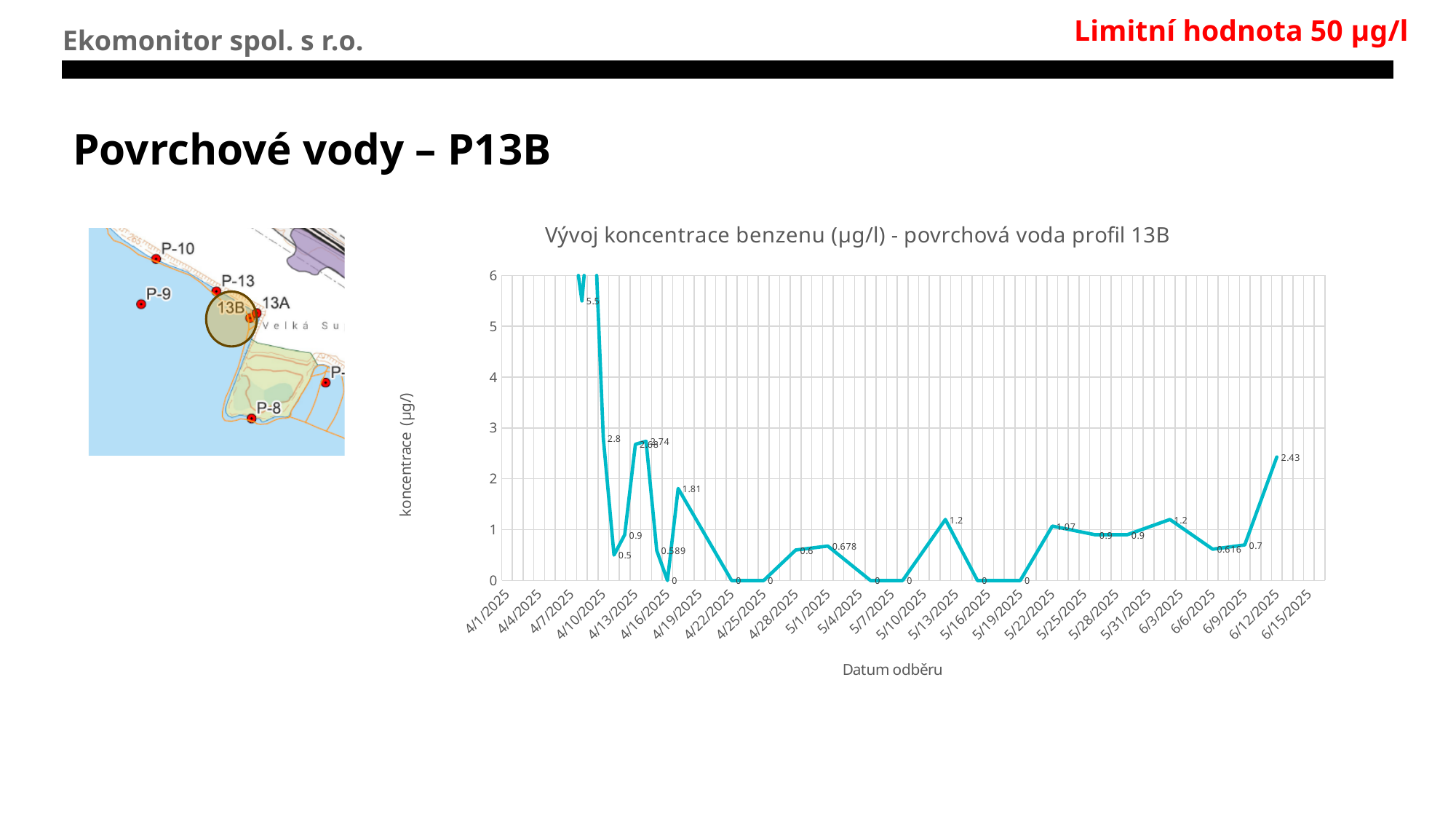
How many data series are plotted on the chart? 1 What kind of chart is shown on the slide? line chart Do the plotted values generally rise or fall between 4/10/2025 and 4/22/2025? fall What is the lowest value plotted on the chart? 0 What is the difference between the last plotted value (2.43) and the peak value around 4/19/2025 (1.81)? 0.62 Is the value of the last plotted point (around 6/12/2025) greater or less than 2? greater What is the title of the chart? Vývoj koncentrace benzenu (µg/l) - povrchová voda profil 13B What is the label of the vertical axis of the chart? koncentrace (µg/l) Which is larger: the peak value around 4/19/2025 or the value of the last plotted point around 6/12/2025? the last plotted point (2.43) What is the value of the last plotted point on the chart (around 6/12/2025)? 2.43 Is the peak value around 4/19/2025 greater or less than 2? less Do the plotted values rise or fall between 6/9/2025 and 6/12/2025? rise